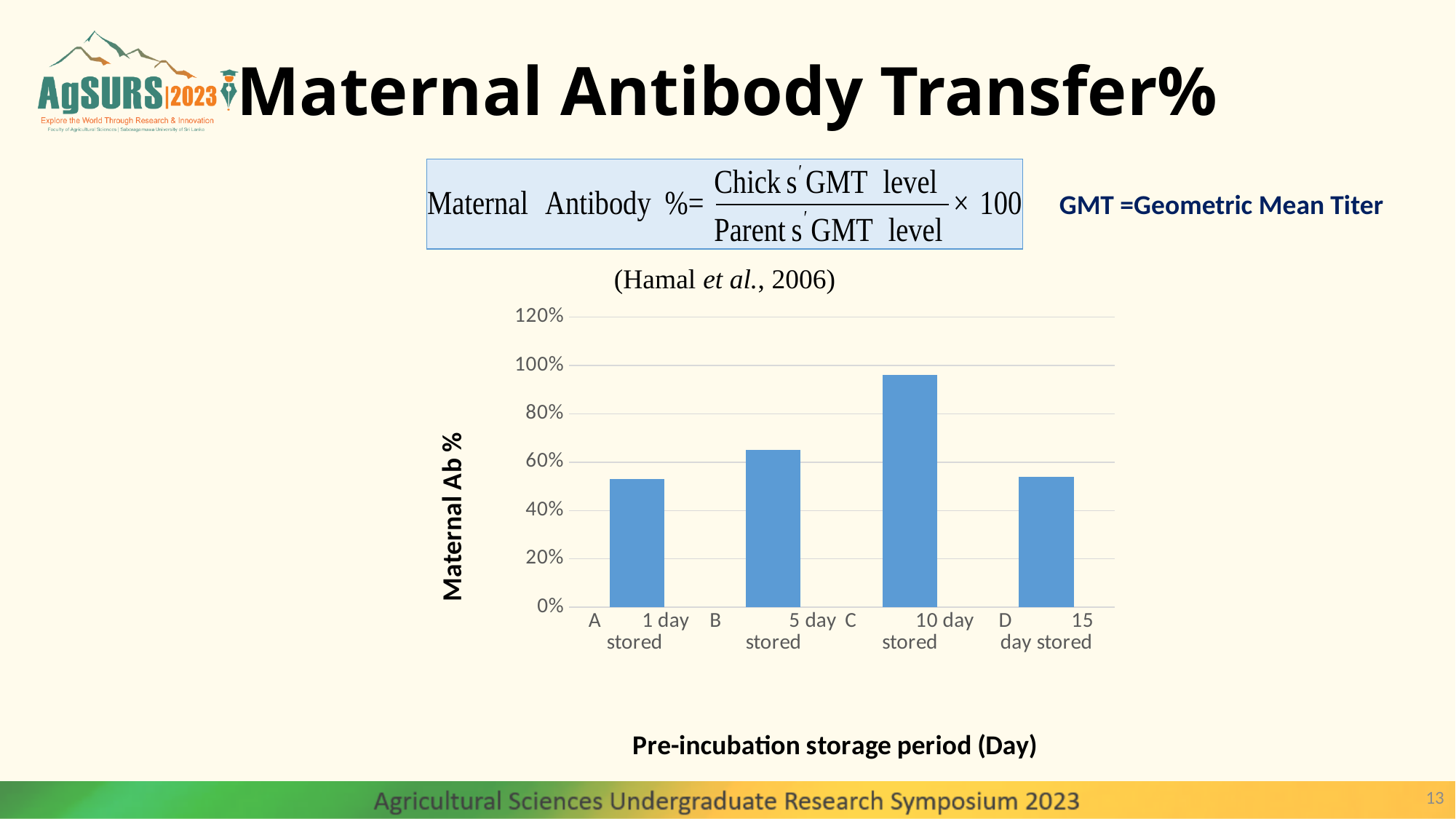
What is the highest value shown on the vertical axis of the chart? 120% What kind of chart is shown on the slide? bar chart How many storage period categories are plotted in the chart? 4 Which has a higher Maternal Ab %, C 10 day stored or D 15 day stored? C 10 day stored Is the Maternal Ab % for B 5 day stored greater or less than 60%? greater Is the Maternal Ab % for A 1 day stored greater or less than 60%? less Which storage period has the highest Maternal Ab %? C 10 day stored What is the label of the vertical axis of the chart? Maternal Ab % Is the Maternal Ab % for C 10 day stored greater or less than 80%? greater What is the label of the horizontal axis of the chart? Pre-incubation storage period (Day) Which has a higher Maternal Ab %, B 5 day stored or A 1 day stored? B 5 day stored